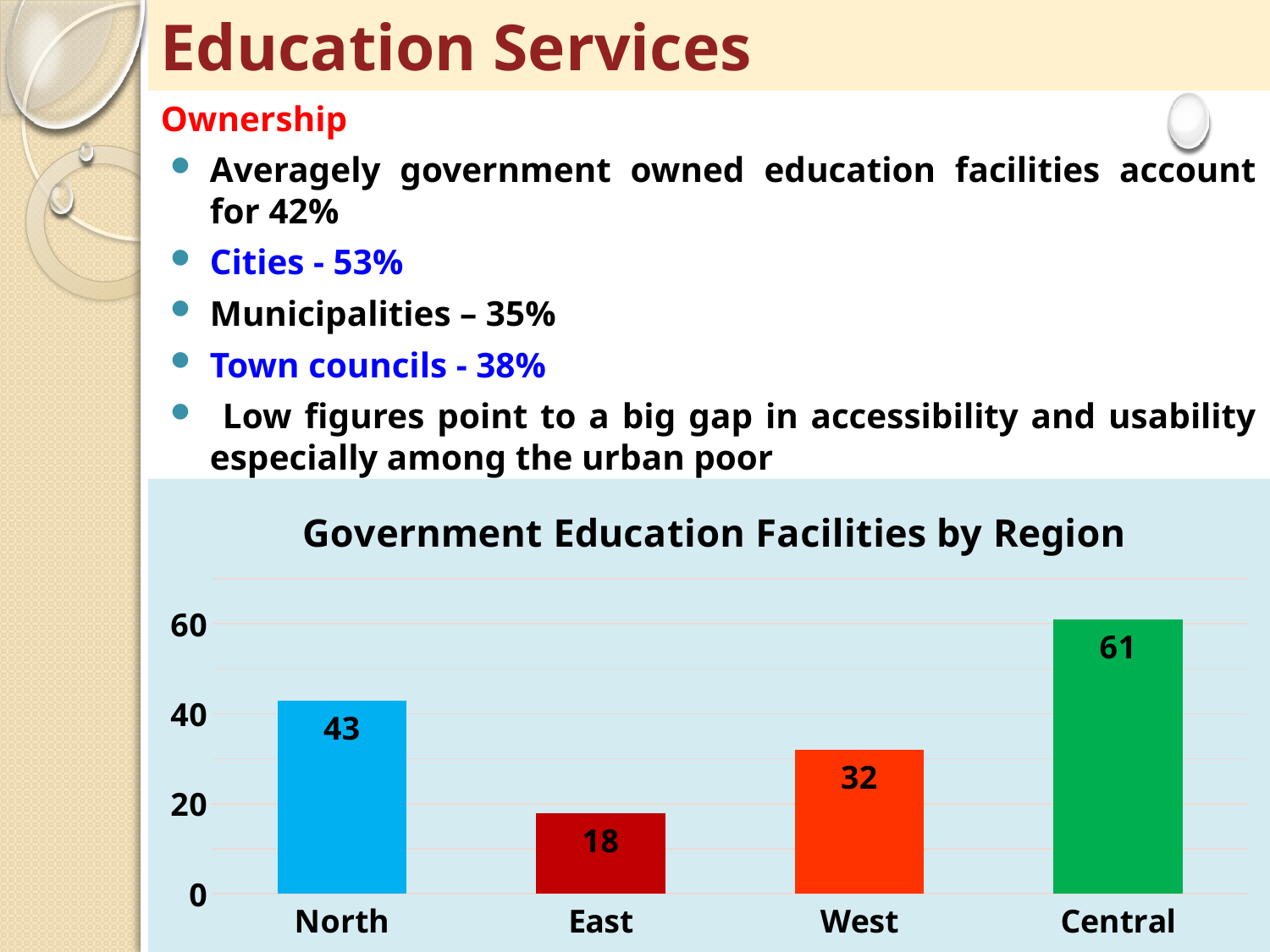
How many regions are shown in the chart? 4 What is the value for North in the Government Education Facilities by Region chart? 43 What is the difference between the values for North and West? 11 What is the value for Central in the chart? 61 Which region has the highest value in the chart? Central What is the value for West in the chart? 32 What is the value for East in the chart? 18 What kind of chart is shown on the slide? Bar chart Is the value for Central greater or less than 40? greater Which is larger, the value for North or the value for West? North What is the difference between the values for Central and East? 43 Which region has the lowest value in the chart? East